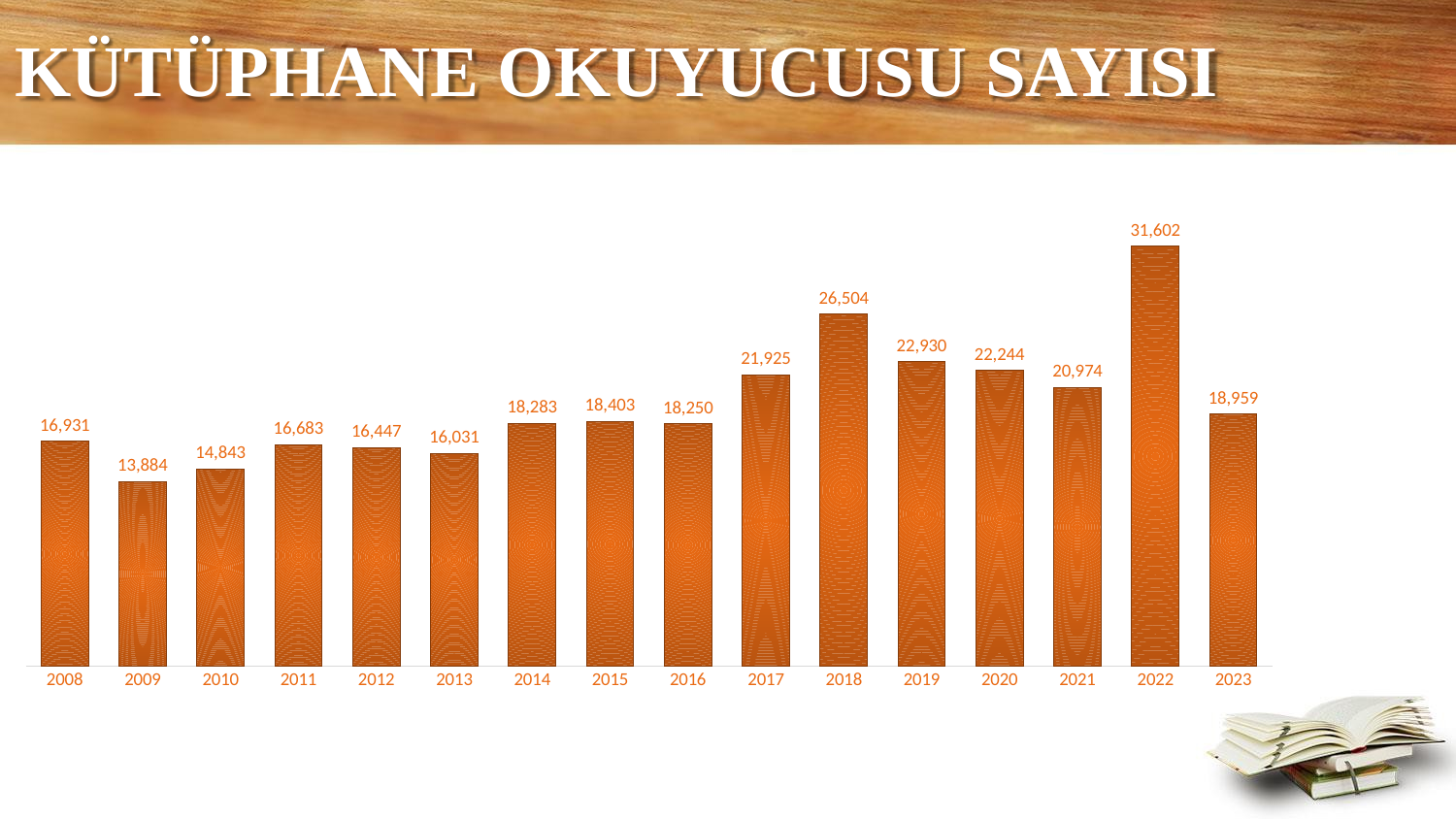
What kind of chart is shown on the slide? Bar chart What is the difference between the values for 2022 and 2021? 10,628 Which year has the highest value? 2022 Which is larger, the value for 2019 or the value for 2020? 2019 What is the difference between the values for 2018 and 2017? 4,579 How many years are shown on the x axis? 16 Do the values rise or fall from 2013 to 2018? Rise What is the value for 2017? 21,925 What is the value for 2022? 31,602 What is the value for 2023? 18,959 What is the value for 2009? 13,884 Which year has the lowest value? 2009